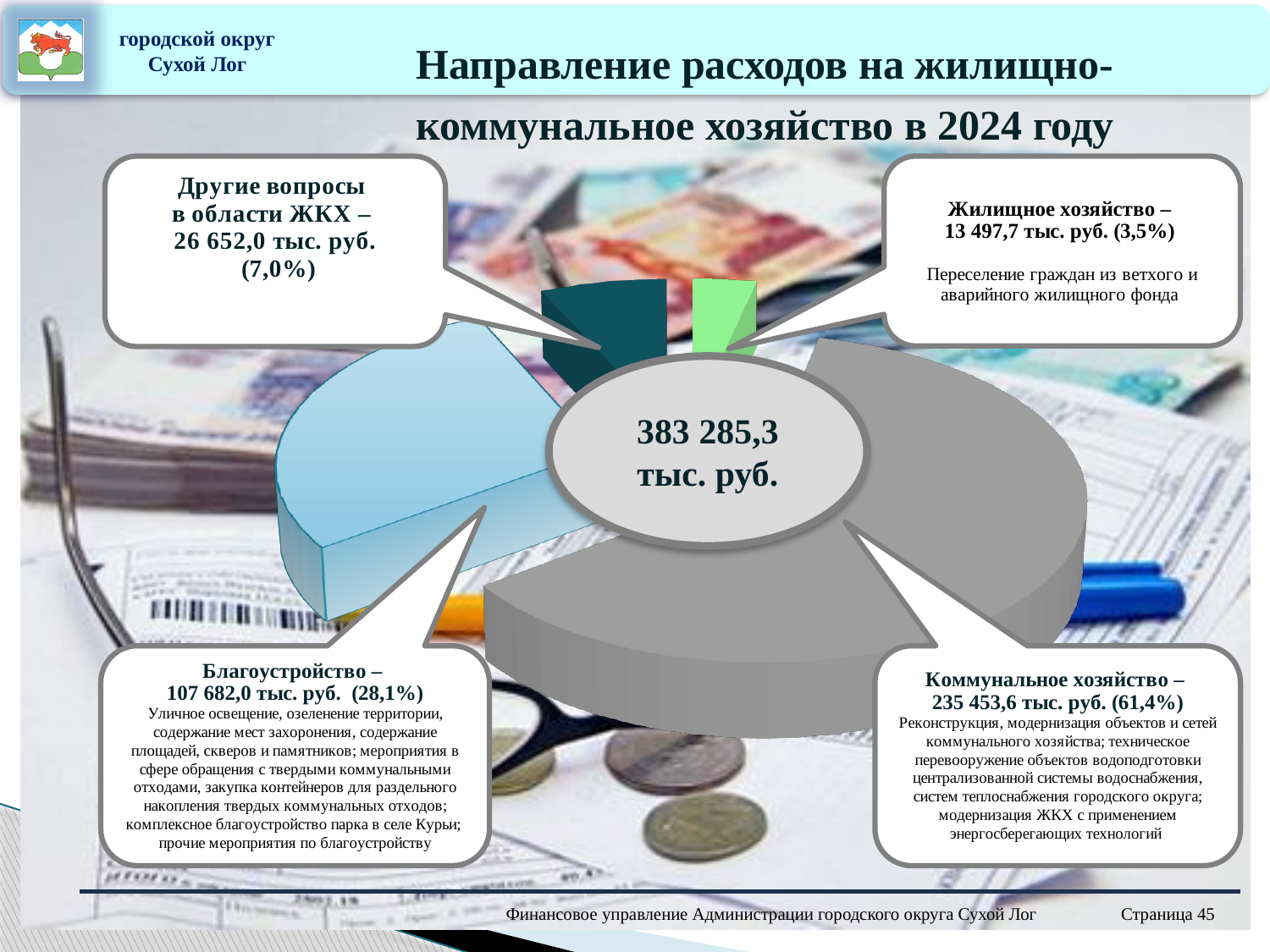
What kind of chart is shown on the slide? pie chart What share of the pie does Благоустройство represent? 28,1% Which is larger: the value for Другие вопросы в области ЖКХ or the value for Жилищное хозяйство? Другие вопросы в области ЖКХ What is the value for Другие вопросы в области ЖКХ? 26 652,0 тыс. руб. What is the difference between the values for Коммунальное хозяйство and Благоустройство? 127 771,6 тыс. руб. How many categories does the pie chart show? 4 What is the value for Жилищное хозяйство? 13 497,7 тыс. руб. What is the value for Коммунальное хозяйство? 235 453,6 тыс. руб. What is the value for Благоустройство? 107 682,0 тыс. руб. Which category has the largest share of the pie? Коммунальное хозяйство Which category has the smallest share of the pie? Жилищное хозяйство What share of the pie does Коммунальное хозяйство represent? 61,4%